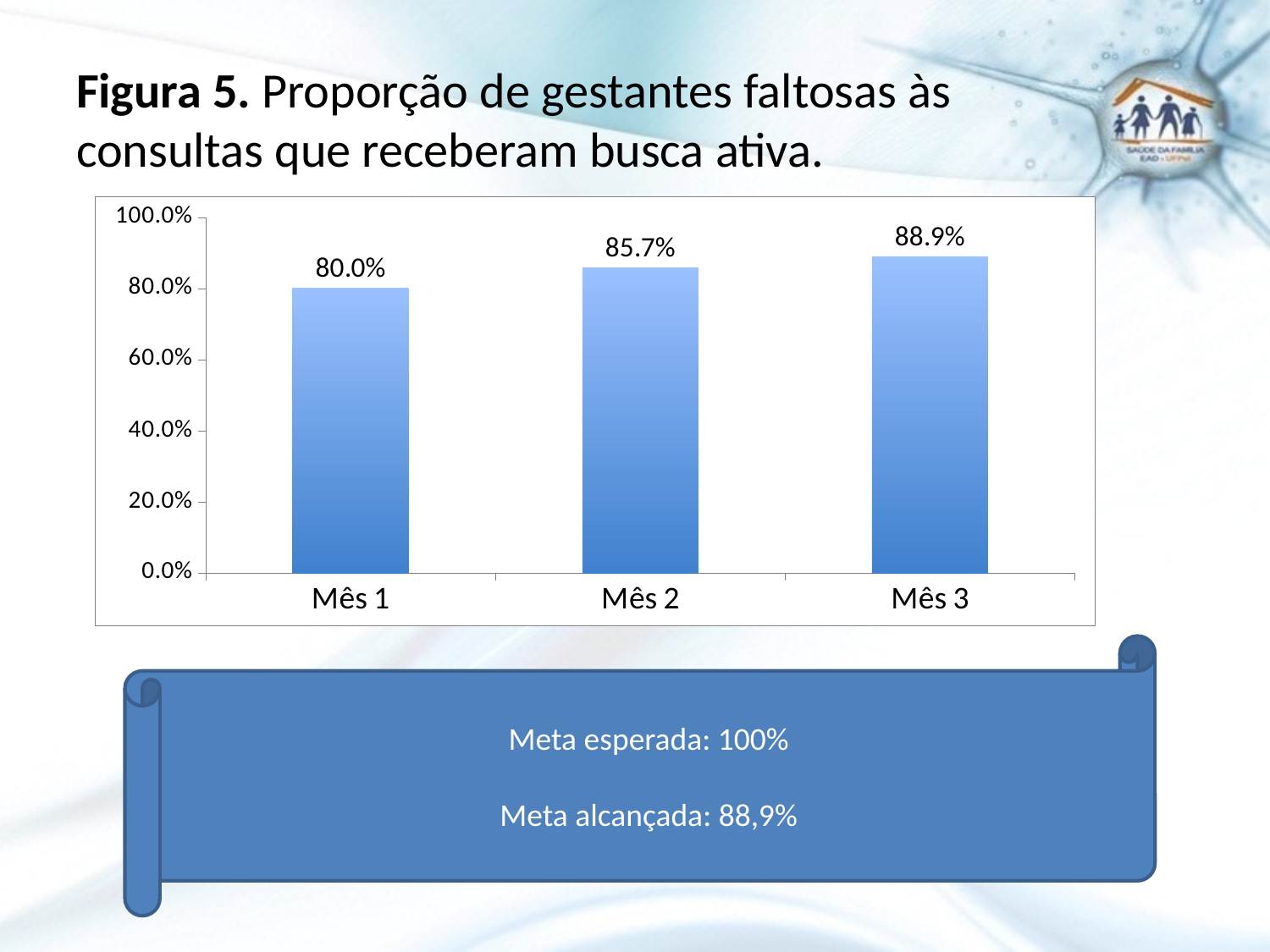
Which is larger, the value for Mês 2 or the value for Mês 3? Mês 3 Is the value for Mês 1 greater or less than 60.0%? greater Do the values rise or fall from Mês 1 to Mês 3? rise Which month has the highest value? Mês 3 What is the value for Mês 2? 85.7% What is the value for Mês 1? 80.0% What is the value for Mês 3? 88.9% What kind of chart is shown on the slide? bar chart How many months are shown on the x axis? 3 What is the difference between the values for Mês 2 and Mês 1? 5.7% What is the difference between the values for Mês 3 and Mês 1? 8.9% Which month has the lowest value? Mês 1